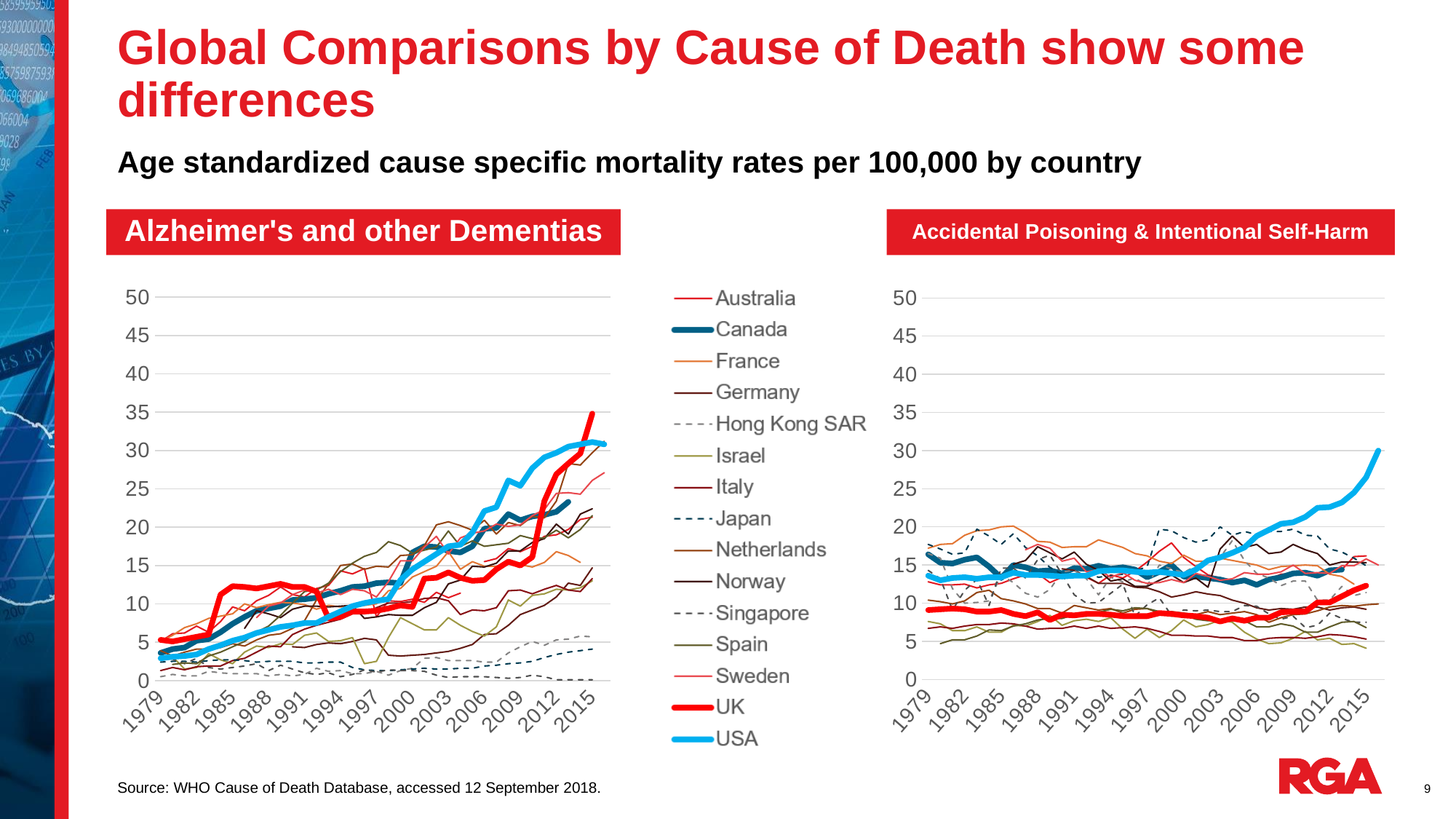
In the Accidental Poisoning & Intentional Self-Harm chart, does the USA line rise or fall between 2000 and 2015? Rise In the Alzheimer's and other Dementias chart, is the USA value in 1979 greater or less than 5? less In the Accidental Poisoning & Intentional Self-Harm chart, which country has the highest value in 2015? USA In the Accidental Poisoning & Intentional Self-Harm chart, which is larger in 2015, the USA value or the UK value? USA In the Alzheimer's and other Dementias chart, does the UK line rise or fall from 1979 to 2015? Rise In the Accidental Poisoning & Intentional Self-Harm chart, is the USA value in 2015 greater or less than 25? greater In the Alzheimer's and other Dementias chart, is the UK value in 2015 greater or less than 30? greater In the Alzheimer's and other Dementias chart, which country has the highest value in 2015? UK What kind of chart is the Alzheimer's and other Dementias chart? Line chart What is the highest value shown on the y axis of the Accidental Poisoning & Intentional Self-Harm chart? 50 How many countries does the legend list? 15